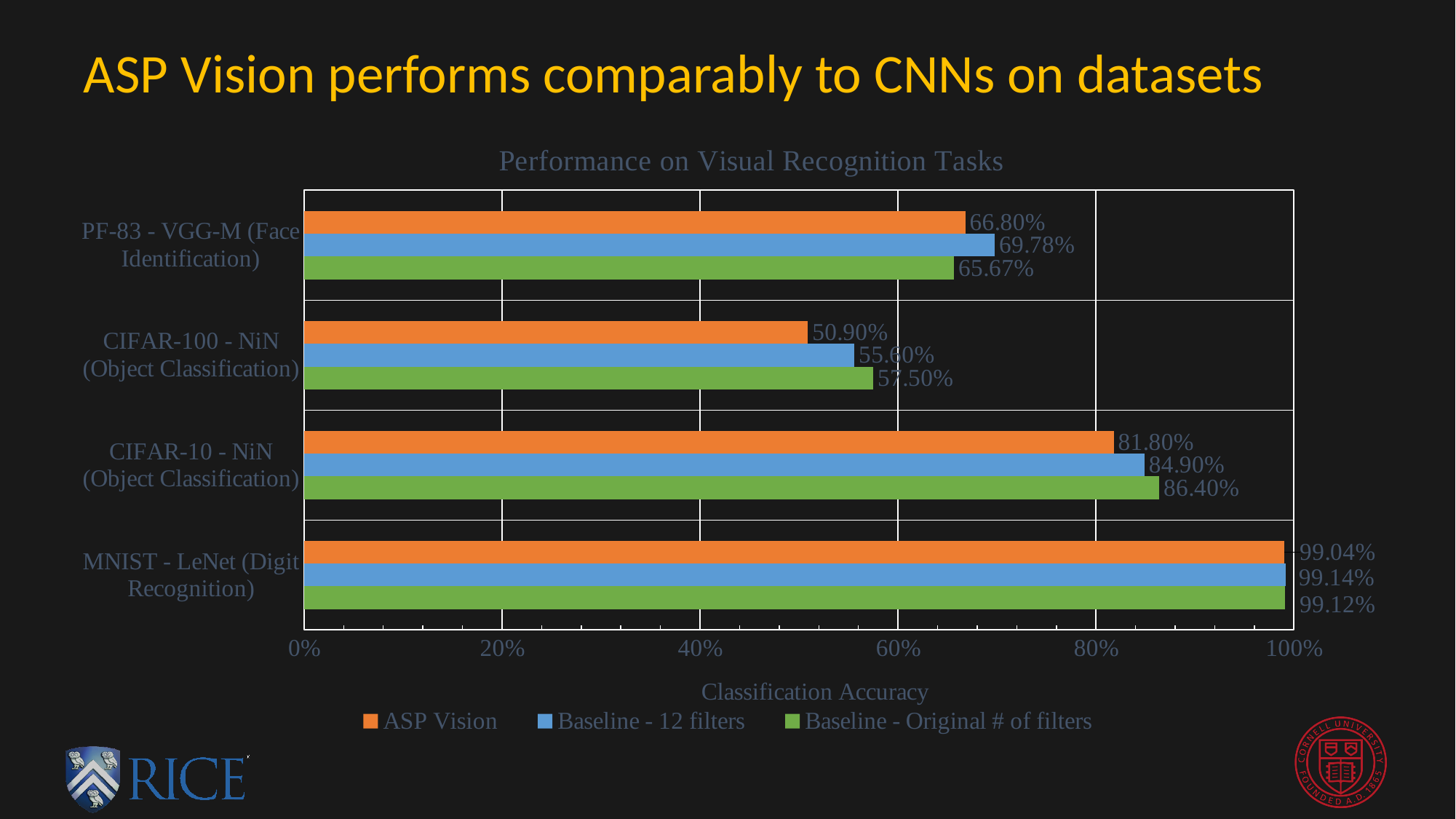
What is the difference between the Baseline - 12 filters and ASP Vision accuracies for CIFAR-10 - NiN (Object Classification)? 3.10% What is the Baseline - Original # of filters accuracy for CIFAR-10 - NiN (Object Classification)? 86.40% Is the ASP Vision value for CIFAR-100 - NiN (Object Classification) greater or less than 60%? less How many series does the legend list? 3 What is the title of the chart? Performance on Visual Recognition Tasks Which dataset has the highest ASP Vision accuracy? MNIST - LeNet (Digit Recognition) For PF-83 - VGG-M (Face Identification), which is larger: ASP Vision or Baseline - Original # of filters? ASP Vision What is the ASP Vision classification accuracy for CIFAR-100 - NiN (Object Classification)? 50.90% How many datasets are shown on the chart? 4 What is the Baseline - 12 filters accuracy for PF-83 - VGG-M (Face Identification)? 69.78% Which dataset has the lowest Baseline - Original # of filters accuracy? CIFAR-100 - NiN (Object Classification) What kind of chart is shown on the slide? Bar chart